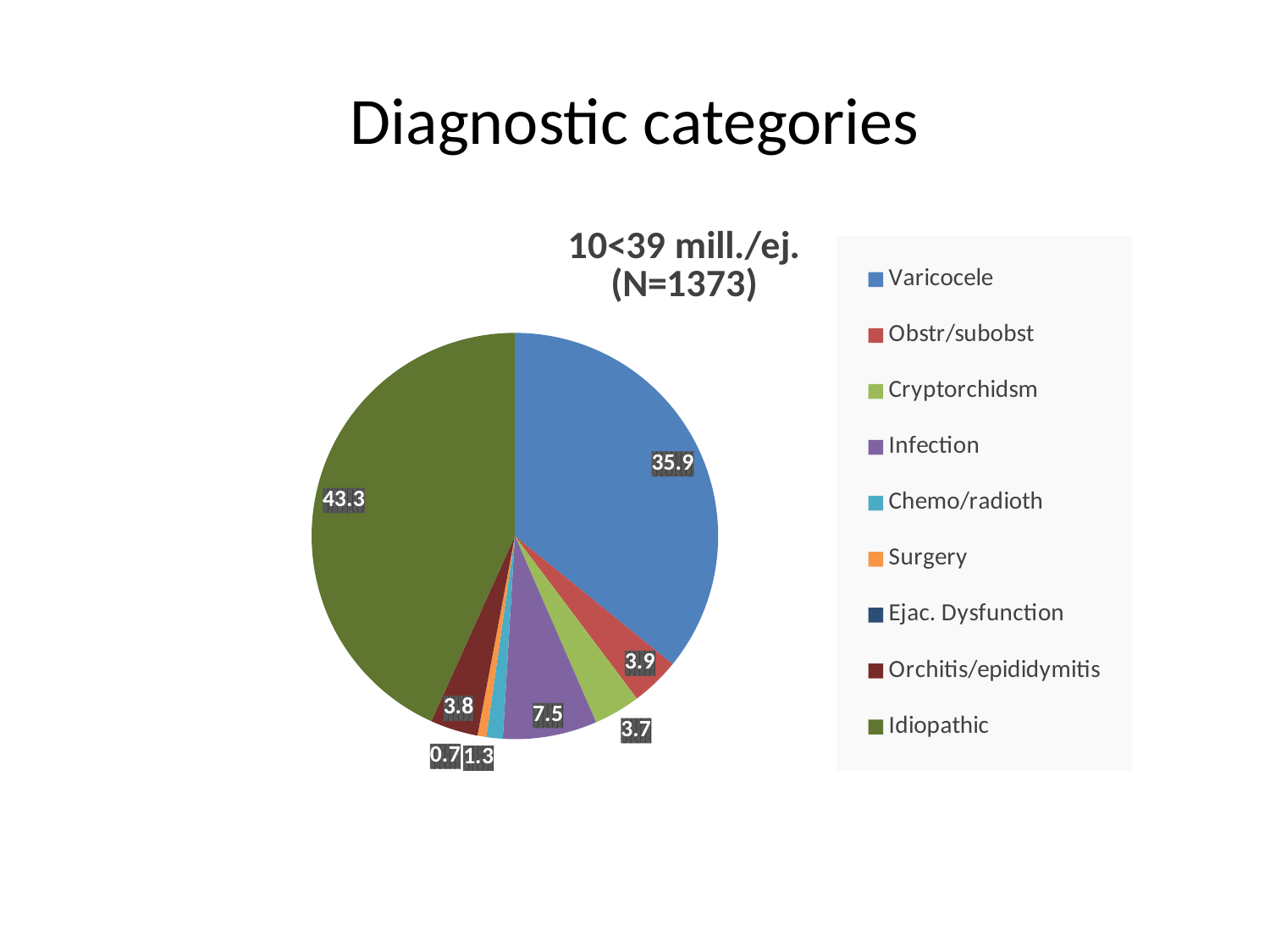
What is the value shown for Orchitis/epididymitis? 3.8 What is the value shown for Varicocele? 35.9 What is the title of the pie chart? 10<39 mill./ej. (N=1373) How many categories does the legend list? 9 Which is larger, the slice for Infection or the slice for Obstr/subobst? Infection Which is larger, the slice for Varicocele or the slice for Idiopathic? Idiopathic What is the value shown for Idiopathic? 43.3 What is the difference between the values for Idiopathic and Varicocele? 7.4 What type of chart is shown on the slide? pie chart Which category has the largest slice of the pie? Idiopathic What is the sample size (N) given in the chart title? 1373 What is the value shown for Infection? 7.5